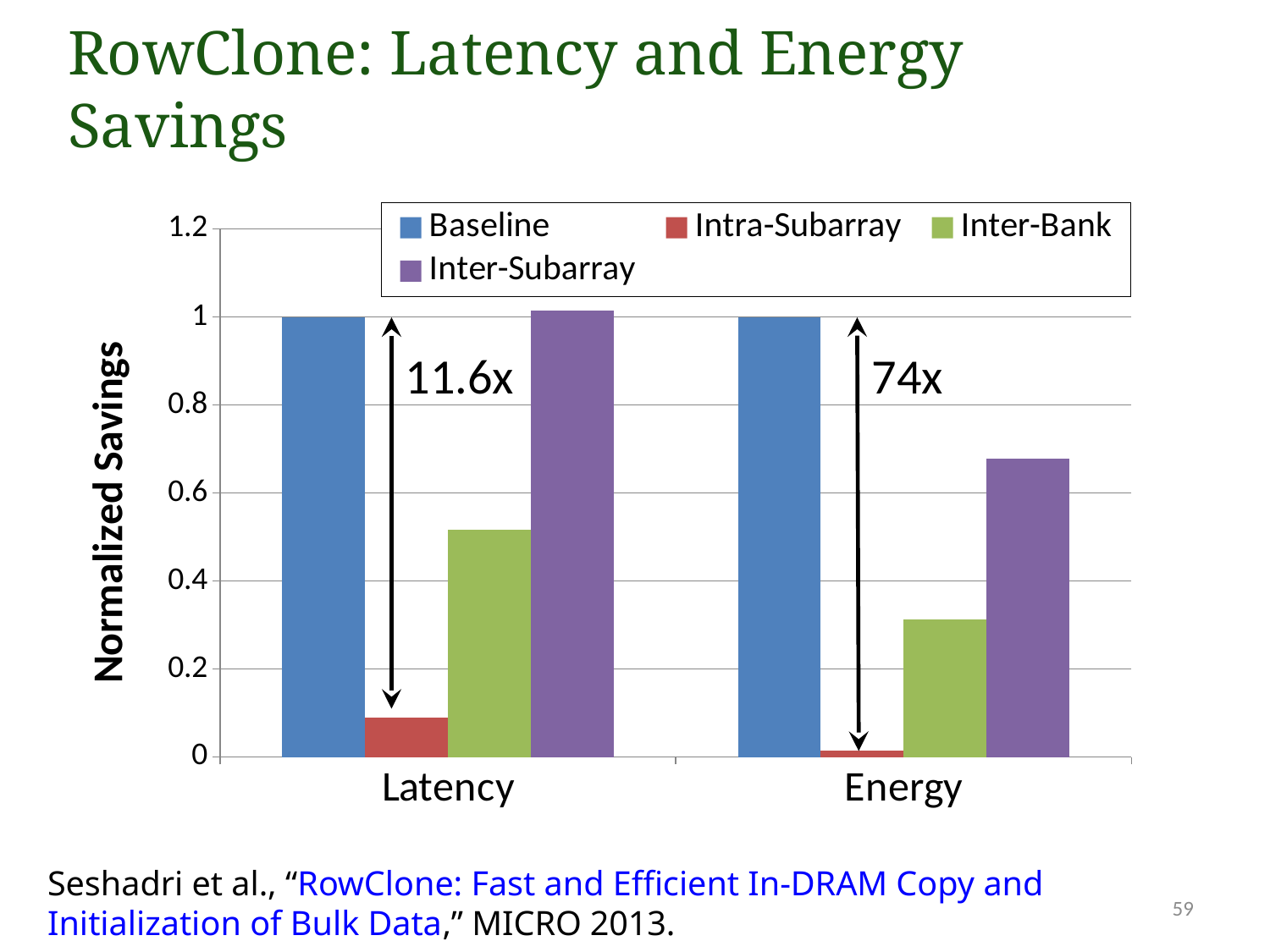
How many categories are shown on the x axis? 2 What is the Baseline value for Latency? 1 Which series has the highest value for Energy? Baseline How many series does the legend list? 4 Is the Inter-Bank value for Energy greater or less than 0.4? less What is the Baseline value for Energy? 1 Is the Intra-Subarray value for Latency greater or less than 0.2? less What kind of chart is shown on the slide? bar chart Is the Inter-Subarray value for Energy greater or less than 0.6? greater Which series has the lowest value for Energy? Intra-Subarray Which is larger, the Inter-Bank value for Latency or the Inter-Bank value for Energy? Latency